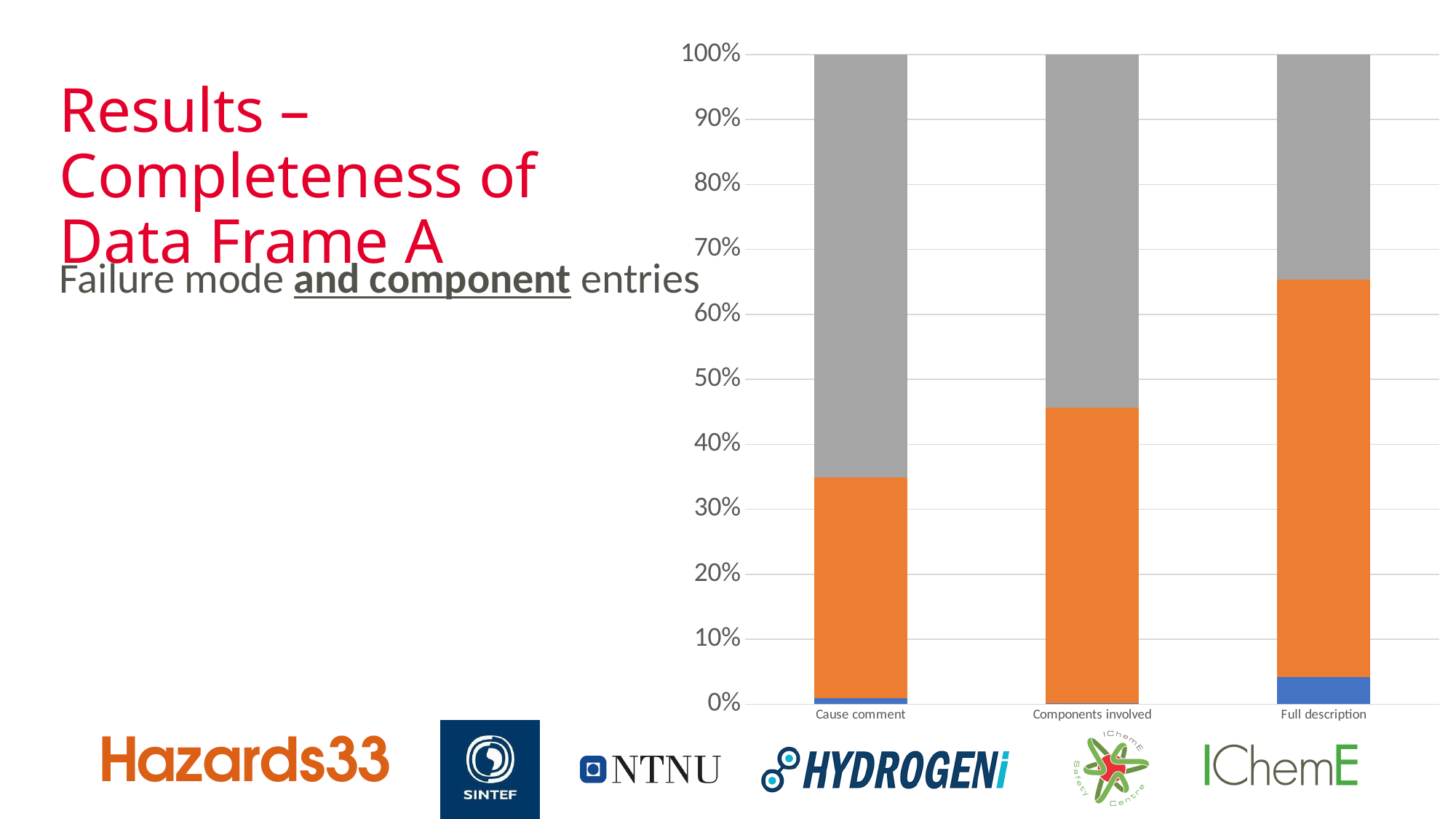
What kind of chart is shown on the slide? Stacked bar chart Which has a larger orange segment, Components involved or Full description? Full description How many categories are shown on the x axis of the chart? 3 Which category has the largest orange segment? Full description What is the total height of the stacked bar for Cause comment? 100% Is the top of the orange segment for Components involved greater or less than 40%? greater Is the top of the orange segment for Cause comment greater or less than 40%? less Which category has the largest grey segment? Cause comment Which category has the smallest orange segment? Cause comment Does the orange segment rise or fall moving from Cause comment to Full description along the x axis? rise Which category has the largest blue segment? Full description Is the top of the orange segment for Full description greater or less than 60%? greater